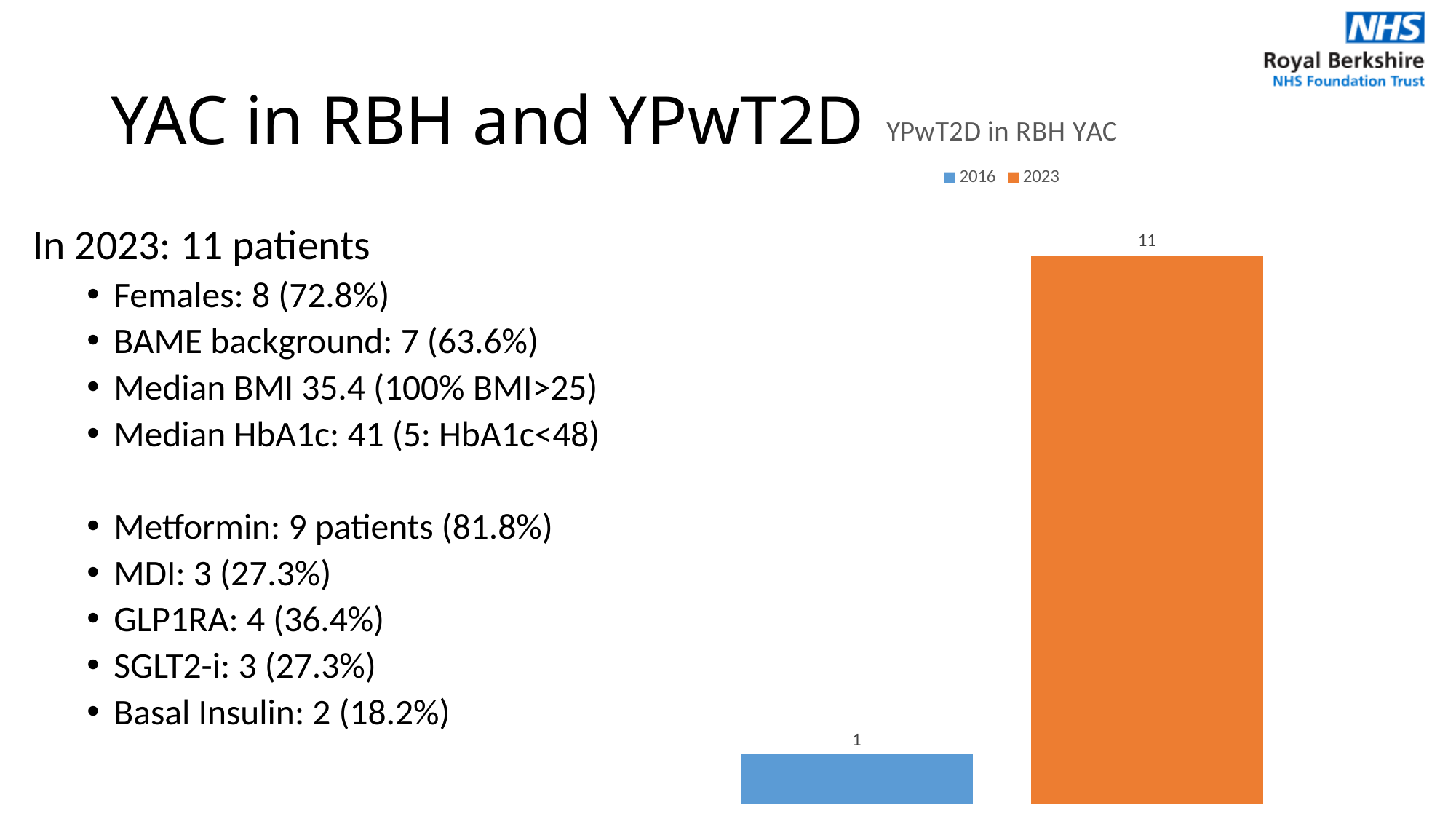
What is the value for 2016 in the chart? 1 What colour is the bar for 2023? Orange What kind of chart is shown on the slide? Bar chart What is the value for 2023 in the chart? 11 Which series has the lower value, 2016 or 2023? 2016 How many bars are plotted in the chart? 2 How many series does the legend list? 2 Is the value for 2023 larger than the value for 2016? Yes Which series has the higher value, 2016 or 2023? 2023 What is the difference between the 2023 value and the 2016 value? 10 What is the title of the chart? YPwT2D in RBH YAC Do the values rise or fall from 2016 to 2023? Rise